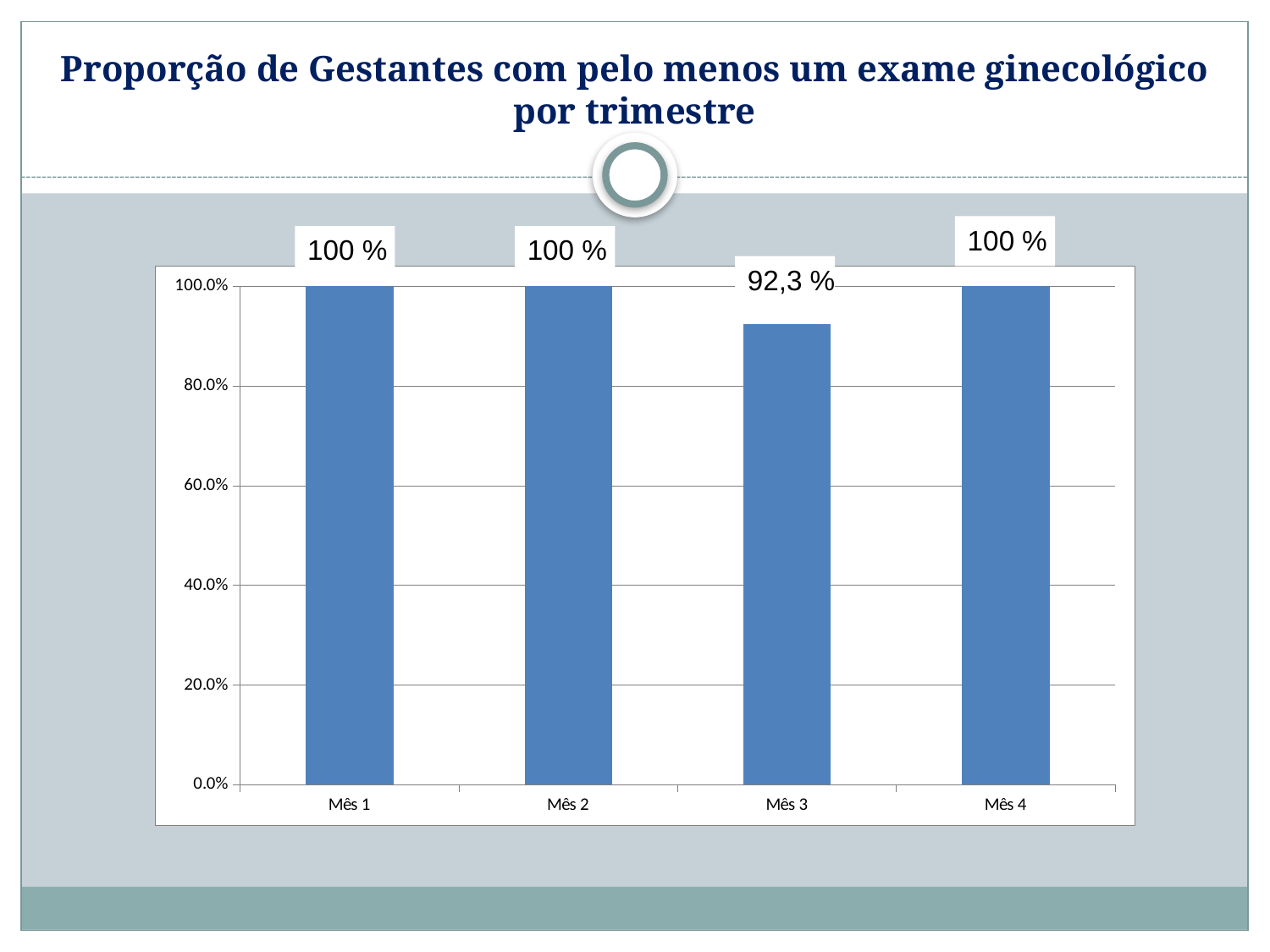
Is the value for Mês 3 greater or less than 80.0%? greater Which is larger, the value for Mês 3 or the value for Mês 4? Mês 4 What is the value for Mês 1? 100 % How many months are shown on the x axis? 4 What is the difference between the value for Mês 2 and the value for Mês 3? 7,7 % What is the value for Mês 4? 100 % How many months have a value of 100 %? 3 What is the highest value shown on the y axis? 100.0% What kind of chart is shown on the slide? bar chart Which month has the lowest value? Mês 3 What is the value for Mês 3? 92,3 % What is the title of the slide? Proporção de Gestantes com pelo menos um exame ginecológico por trimestre